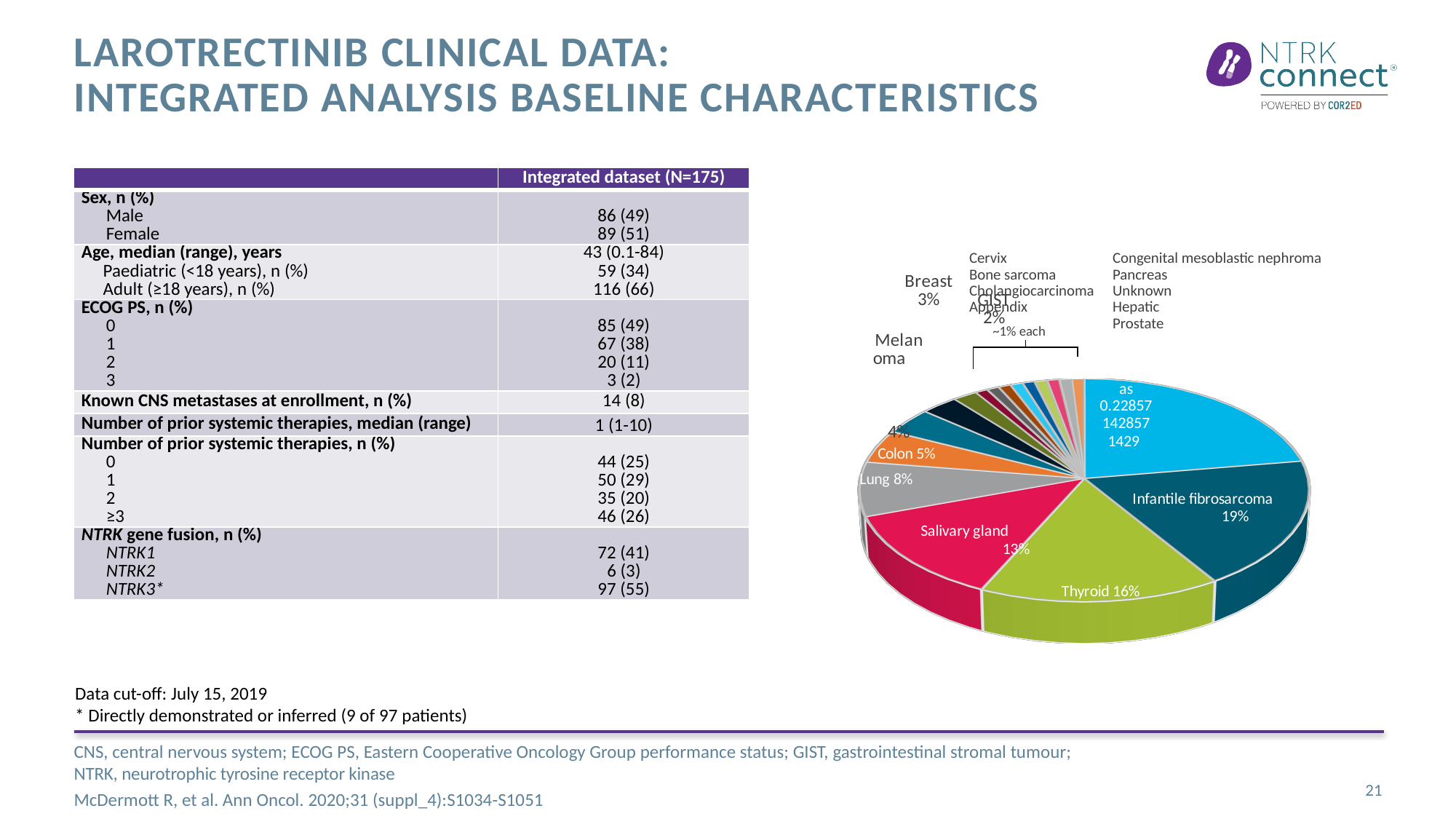
What share of the pie chart does Breast represent? 3% What share of the pie chart does Thyroid represent? 16% What share of the pie chart does Lung represent? 8% In the pie chart, which is larger: Lung or Colon? Lung In the pie chart, which is larger: Thyroid or Salivary gland? Thyroid What share of the pie chart does Infantile fibrosarcoma represent? 19% According to the pie chart, what share does each of Cervix, Bone sarcoma, Cholangiocarcinoma and Appendix represent? ~1% each What share of the pie chart does Colon represent? 5% In the pie chart, what is the difference in percentage points between Infantile fibrosarcoma and Thyroid? 3 percentage points What kind of chart is shown on the right of the slide? Pie chart What share of the pie chart does Salivary gland represent? 13% What share of the pie chart does GIST represent? 2%